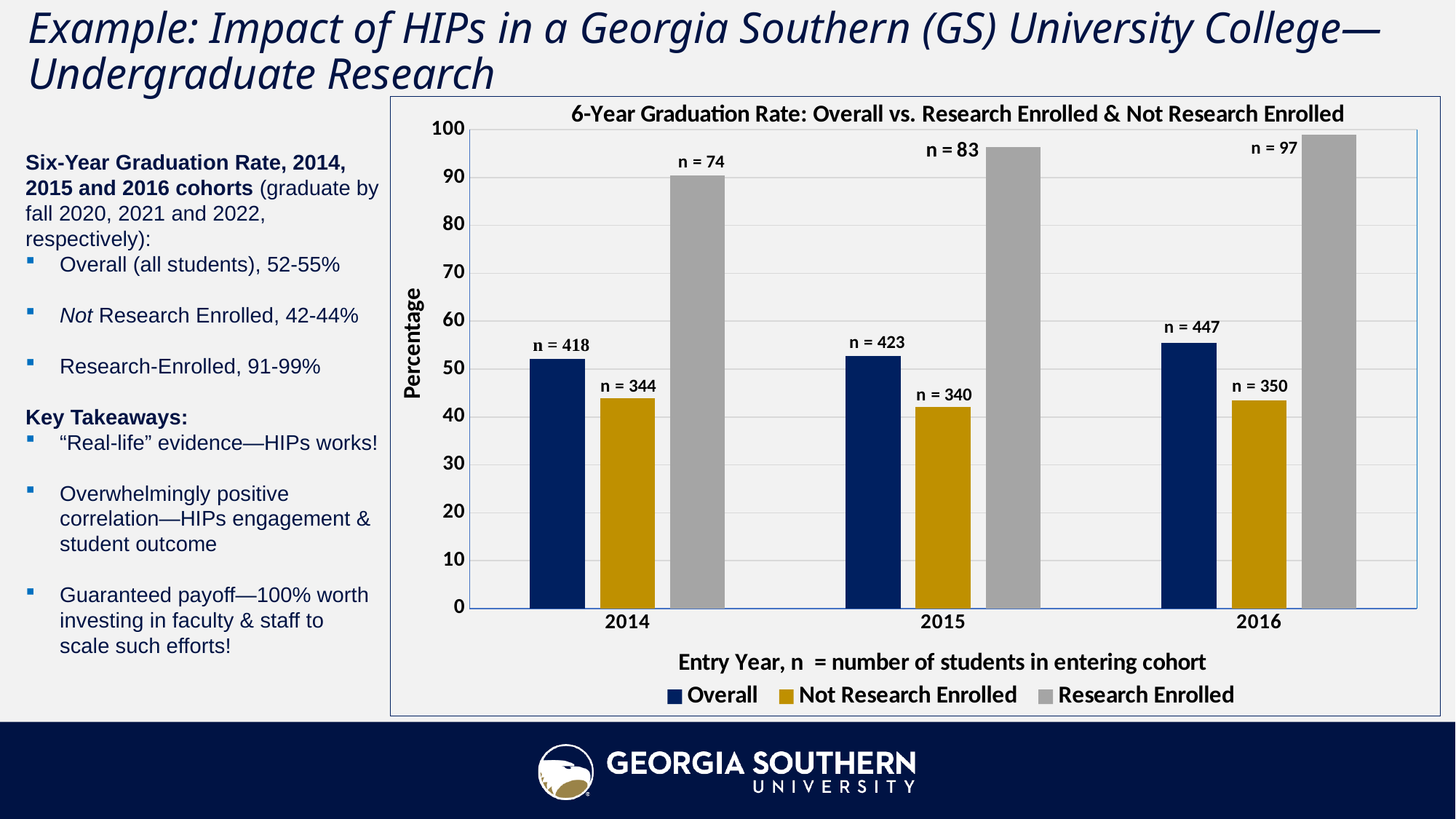
Is the Not Research Enrolled graduation rate for 2015 greater or less than 50? less Does the Research Enrolled graduation rate rise or fall from 2014 to 2016? rise Is the Research Enrolled graduation rate for 2015 greater or less than 90? greater What is the n value printed above the Not Research Enrolled bar for 2015? n = 340 Which series and year has the highest bar in the chart? Research Enrolled, 2016 What type of chart is shown on the slide? bar chart What is the n value printed above the Overall bar for 2014? n = 418 Is the Overall graduation rate for 2014 greater or less than 50? greater What is the title of the chart? 6-Year Graduation Rate: Overall vs. Research Enrolled & Not Research Enrolled How many series does the chart legend list? 3 What is the n value printed above the Research Enrolled bar for 2016? n = 97 How many entry years are shown on the x axis of the chart? 3